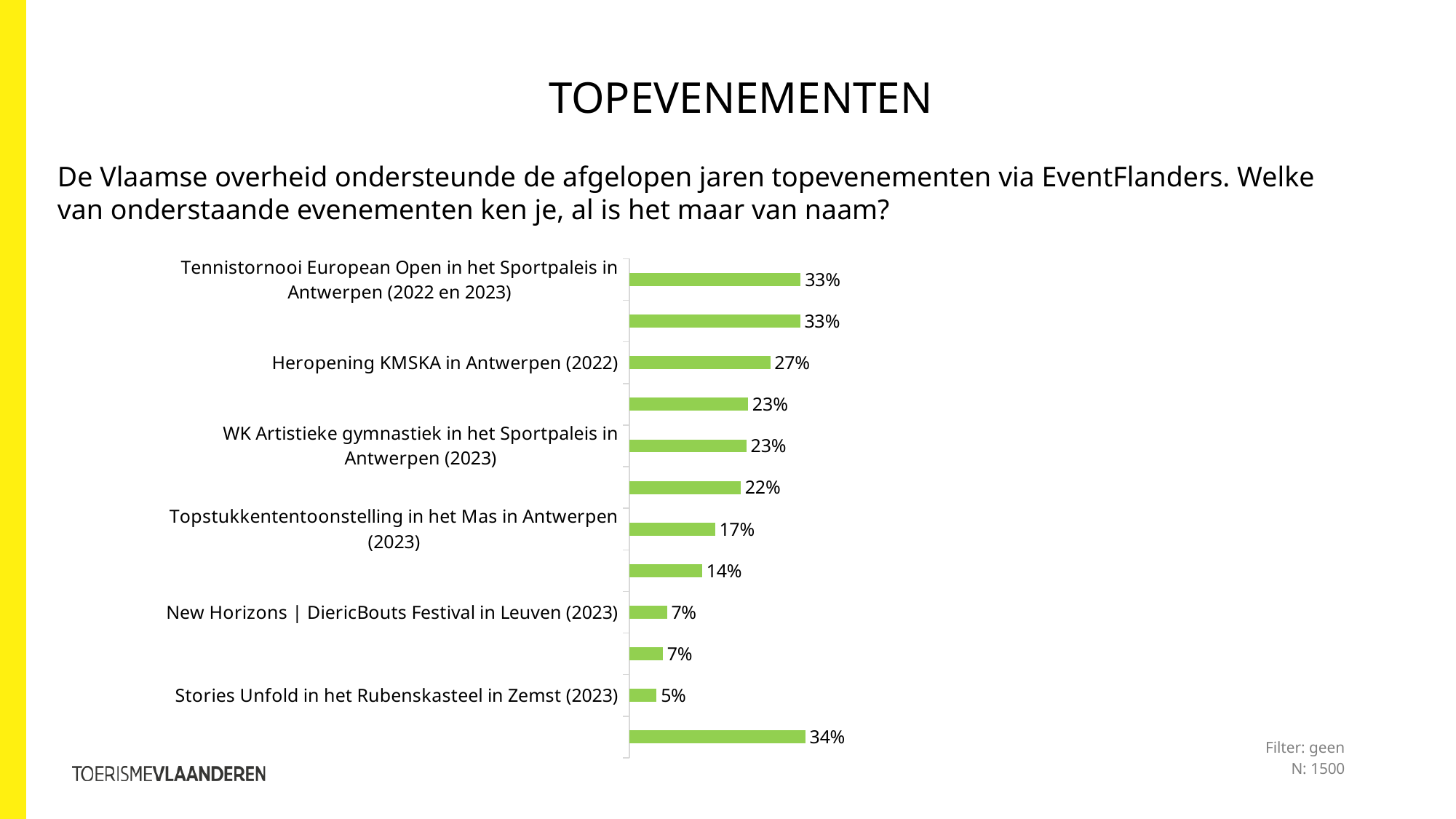
What is the value for New Horizons | DiericBouts Festival in Leuven (2023)? 7% What is the highest value shown on any bar in the chart? 34% What is the value for Tennistornooi European Open in het Sportpaleis in Antwerpen (2022 en 2023)? 33% What is the value for Topstukkententoonstelling in het Mas in Antwerpen (2023)? 17% What is the difference between the values for Tennistornooi European Open and Heropening KMSKA in Antwerpen (2022)? 6 percentage points Which is larger: the value for Heropening KMSKA in Antwerpen (2022) or for WK Artistieke gymnastiek in het Sportpaleis in Antwerpen (2023)? Heropening KMSKA in Antwerpen (2022) What is the value for Heropening KMSKA in Antwerpen (2022)? 27% What is the value for WK Artistieke gymnastiek in het Sportpaleis in Antwerpen (2023)? 23% What is the value for Stories Unfold in het Rubenskasteel in Zemst (2023)? 5% How many bars are plotted in the chart? 12 What kind of chart is shown on the slide? Bar chart Which labelled event has the lowest value in the chart? Stories Unfold in het Rubenskasteel in Zemst (2023)